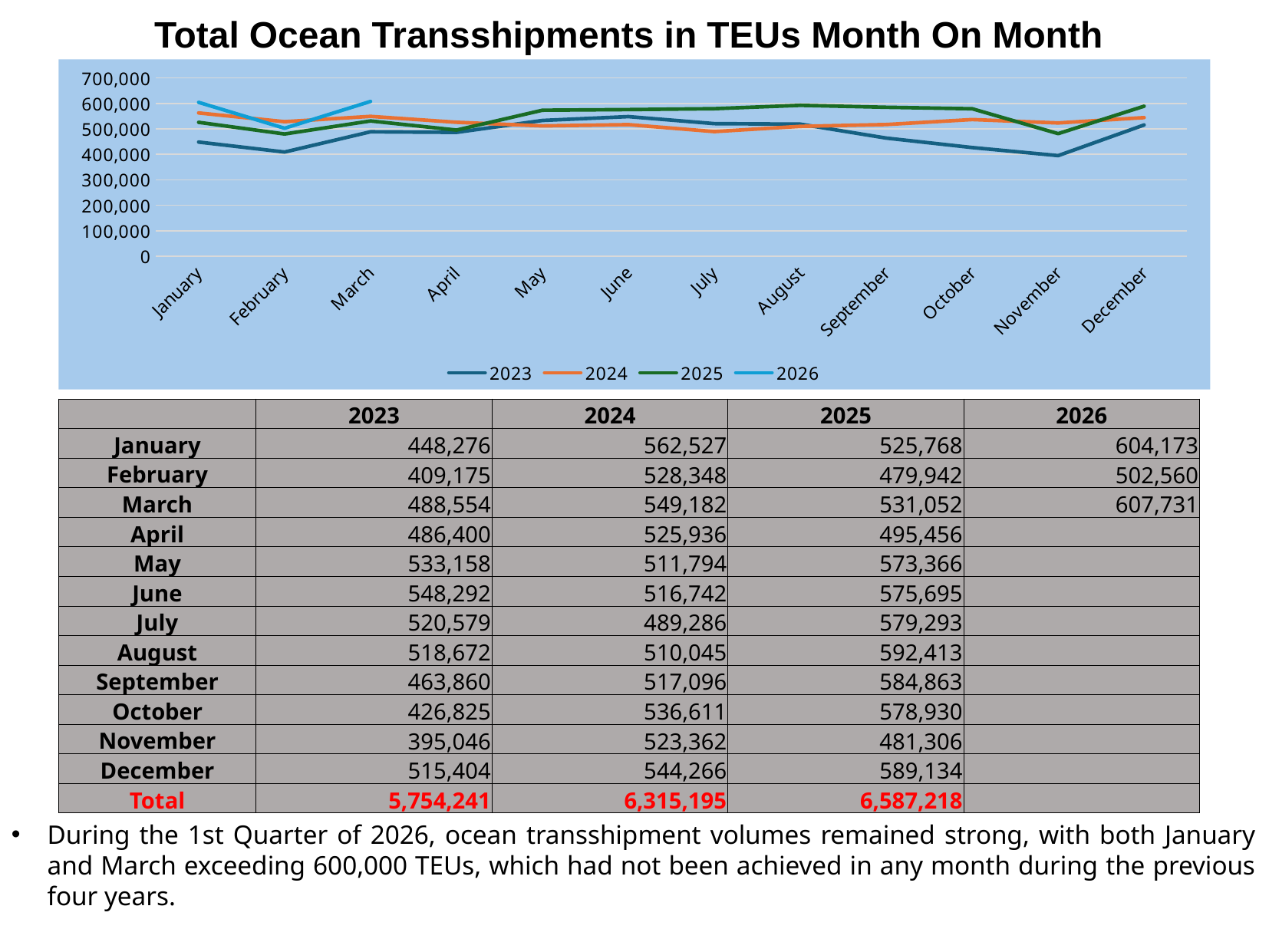
Which month has the highest value in the 2025 series? August Which is larger for January: the 2024 value or the 2025 value? 2024 Is the value for February in the 2023 series greater or less than 500,000? less How many series does the chart legend list? 4 What is the difference between the March and January values in the 2026 series? 3,558 Which month has the lowest value in the 2023 series? November What kind of chart is shown on the slide? line chart What is the title of the chart? Total Ocean Transshipments in TEUs Month On Month Does the 2023 series rise or fall from September to November? fall How many months are plotted along the x axis of the chart? 12 What is the value for November in the 2023 series? 395,046 What is the value for March in the 2026 series? 607,731